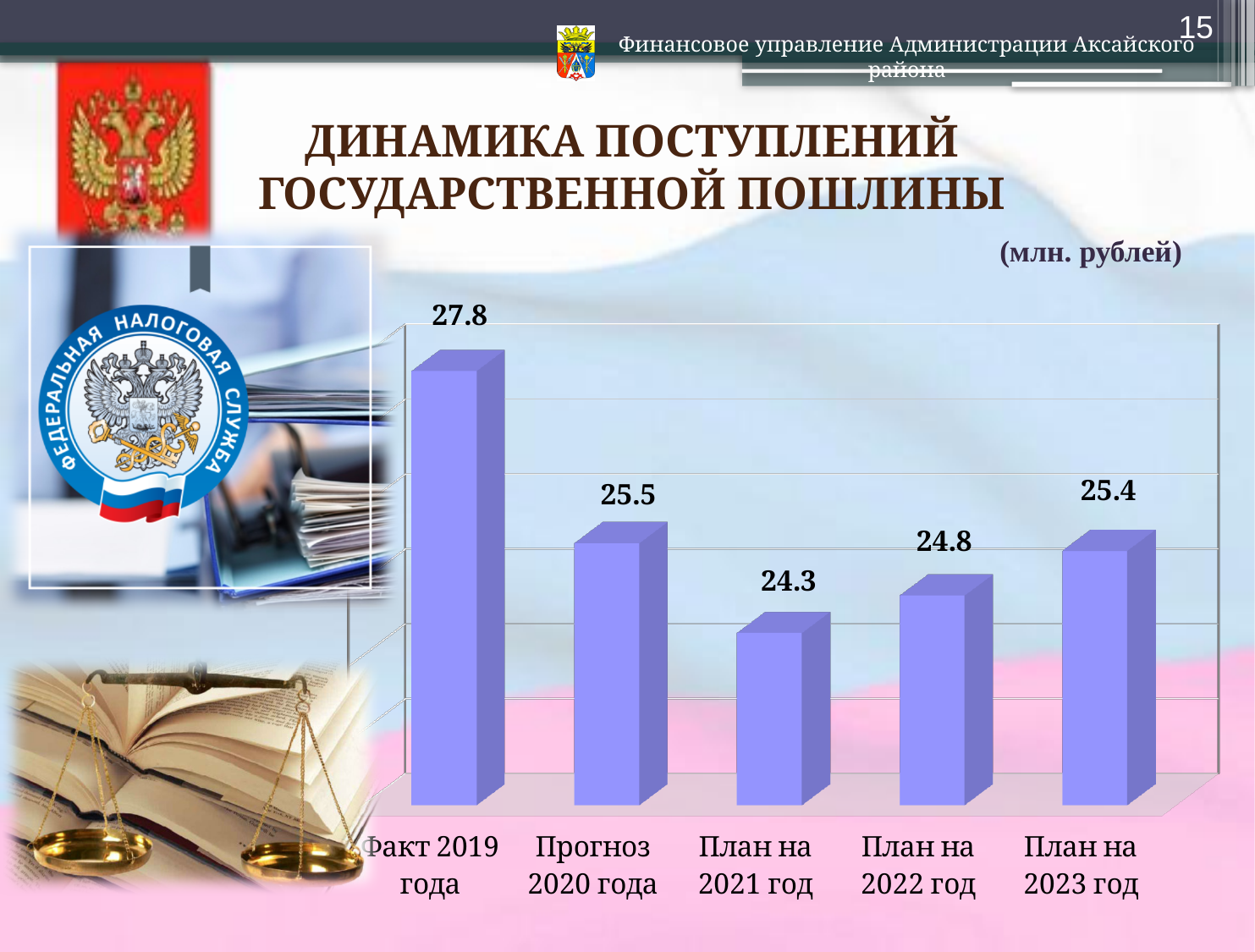
Which category has the lowest value? План на 2021 год What is the value for Факт 2019 года? 27.8 What is the value for План на 2021 год? 24.3 What is the difference between the values for Факт 2019 года and Прогноз 2020 года? 2.3 Which is larger, the value for Прогноз 2020 года or the value for План на 2023 год? Прогноз 2020 года How many categories are shown in the chart? 5 What unit is stated for the chart values? млн. рублей Do the values rise or fall from План на 2021 год to План на 2023 год? rise What is the value for План на 2023 год? 25.4 What kind of chart is shown on the slide? bar chart What is the difference between the values for План на 2023 год and План на 2022 год? 0.6 Which category has the highest value? Факт 2019 года